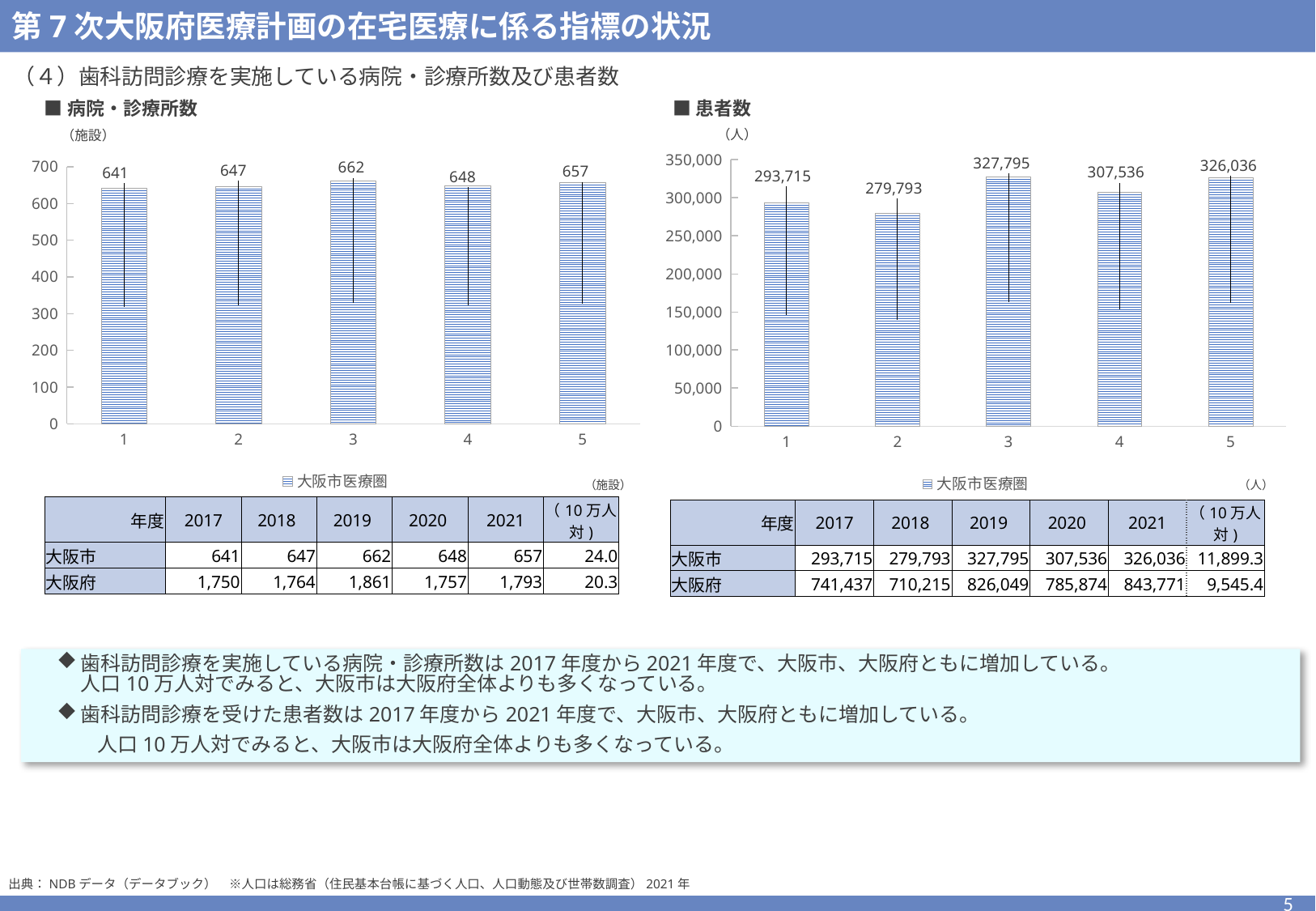
In the 患者数 chart, what is the difference between the values for category 5 and category 1? 32,321 In the 患者数 chart, which is larger, the value for category 4 or the value for category 5? category 5 In the 病院・診療所数 chart, what is the difference between the values for category 3 and category 1? 21 In the 病院・診療所数 chart, which category has the lowest value? 1 In the 患者数 chart, which category has the lowest value? 2 How many series does the legend of the 病院・診療所数 chart list? 1 In the 病院・診療所数 chart, which category has the highest value? 3 What kind of chart is the 患者数 chart? bar chart In the 患者数 chart, what is the value for category 2? 279,793 In the 病院・診療所数 chart, what is the value for category 3? 662 In the 病院・診療所数 chart, how many bars are plotted? 5 In the 患者数 chart, which category has the highest value? 3